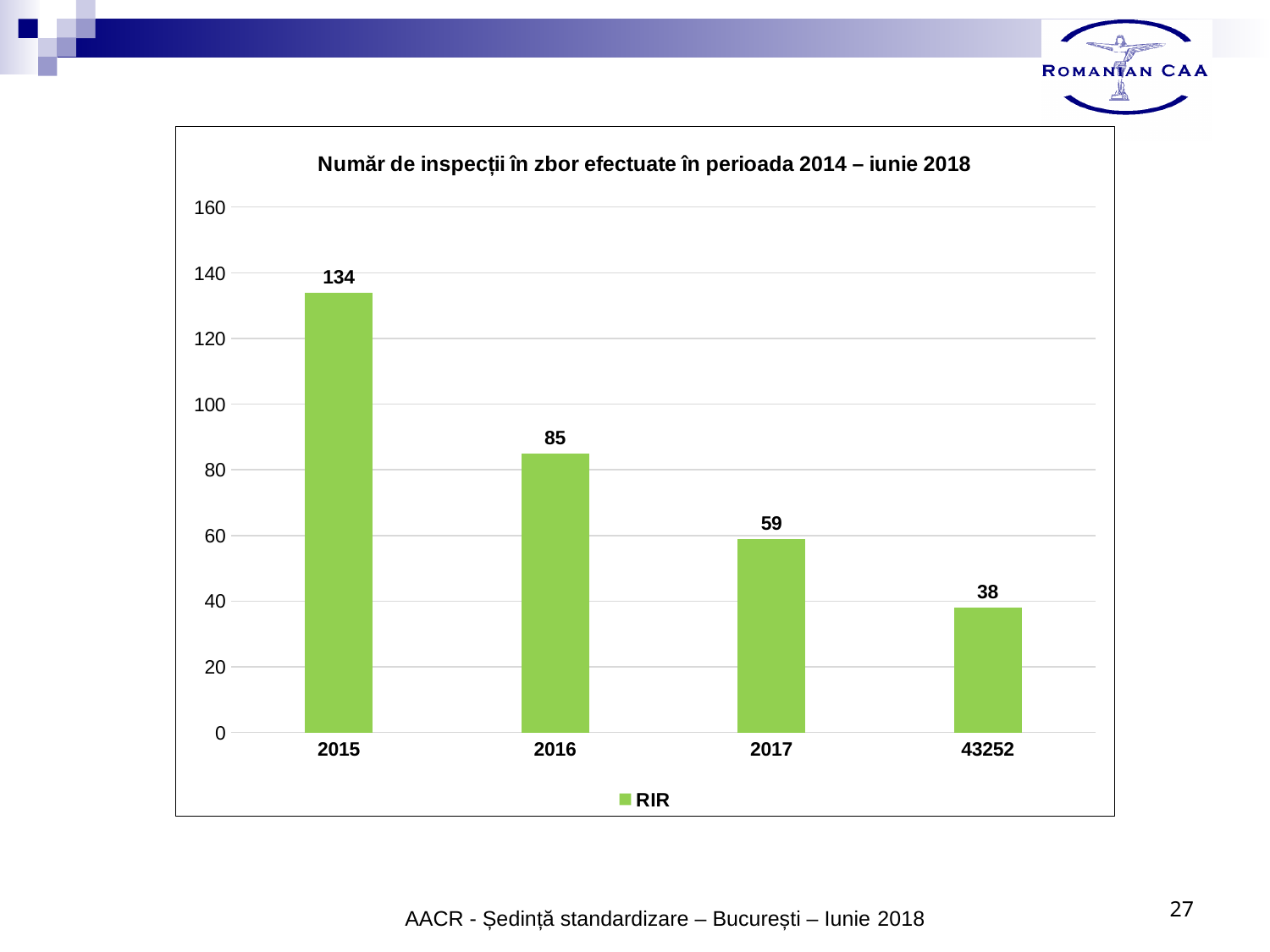
Which is larger, the value for 2016 or the value for 2017? 2016 Which category has the lowest value? 43252 What is the value for 2017? 59 How many series does the legend list? 1 What is the value for the category labelled 43252? 38 What is the value for 2015? 134 Which category has the highest value? 2015 How many categories are shown on the x axis? 4 Do the values rise or fall from left to right along the x axis? fall What is the difference between the values for 2015 and 2016? 49 What is the value for 2016? 85 What kind of chart is shown? bar chart